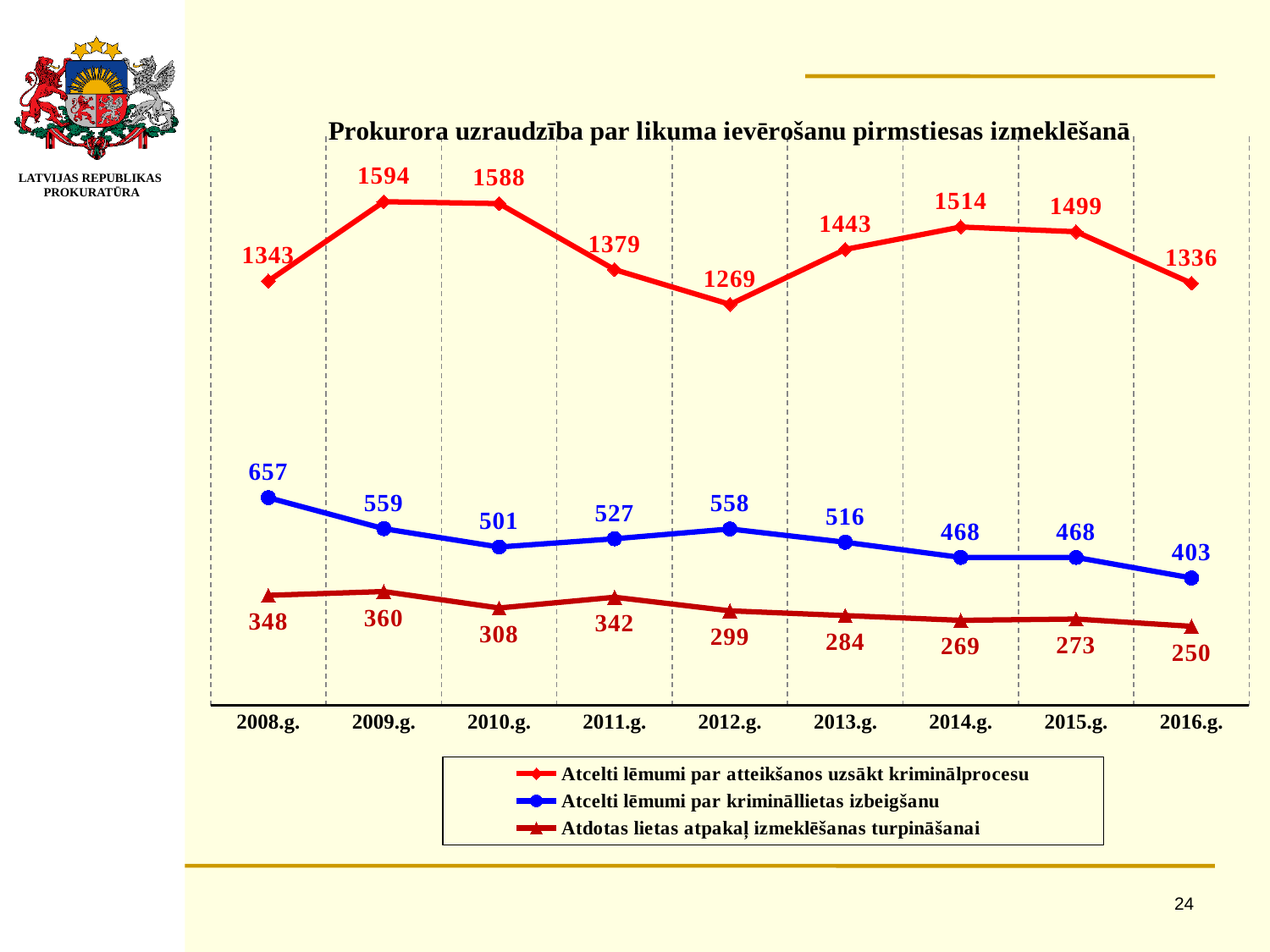
What is the title of the chart? Prokurora uzraudzība par likuma ievērošanu pirmstiesas izmeklēšanā In which year is 'Atcelti lēmumi par atteikšanos uzsākt kriminālprocesu' highest? 2009.g. What kind of chart is shown on the slide? Line chart How many series does the legend list? 3 In which year is 'Atdotas lietas atpakaļ izmeklēšanas turpināšanai' lowest? 2016.g. What is the value for 'Atcelti lēmumi par krimināllietas izbeigšanu' in 2008.g.? 657 What is the value for 'Atdotas lietas atpakaļ izmeklēšanas turpināšanai' in 2016.g.? 250 What is the value for 'Atcelti lēmumi par atteikšanos uzsākt kriminālprocesu' in 2012.g.? 1269 Does 'Atcelti lēmumi par krimināllietas izbeigšanu' generally rise or fall from 2008.g. to 2016.g.? Fall Which is larger for 'Atcelti lēmumi par atteikšanos uzsākt kriminālprocesu': the value in 2014.g. or in 2015.g.? 2014.g. How many years are shown on the x axis? 9 What is the difference between the 2009.g. and 2016.g. values for 'Atcelti lēmumi par krimināllietas izbeigšanu'? 156